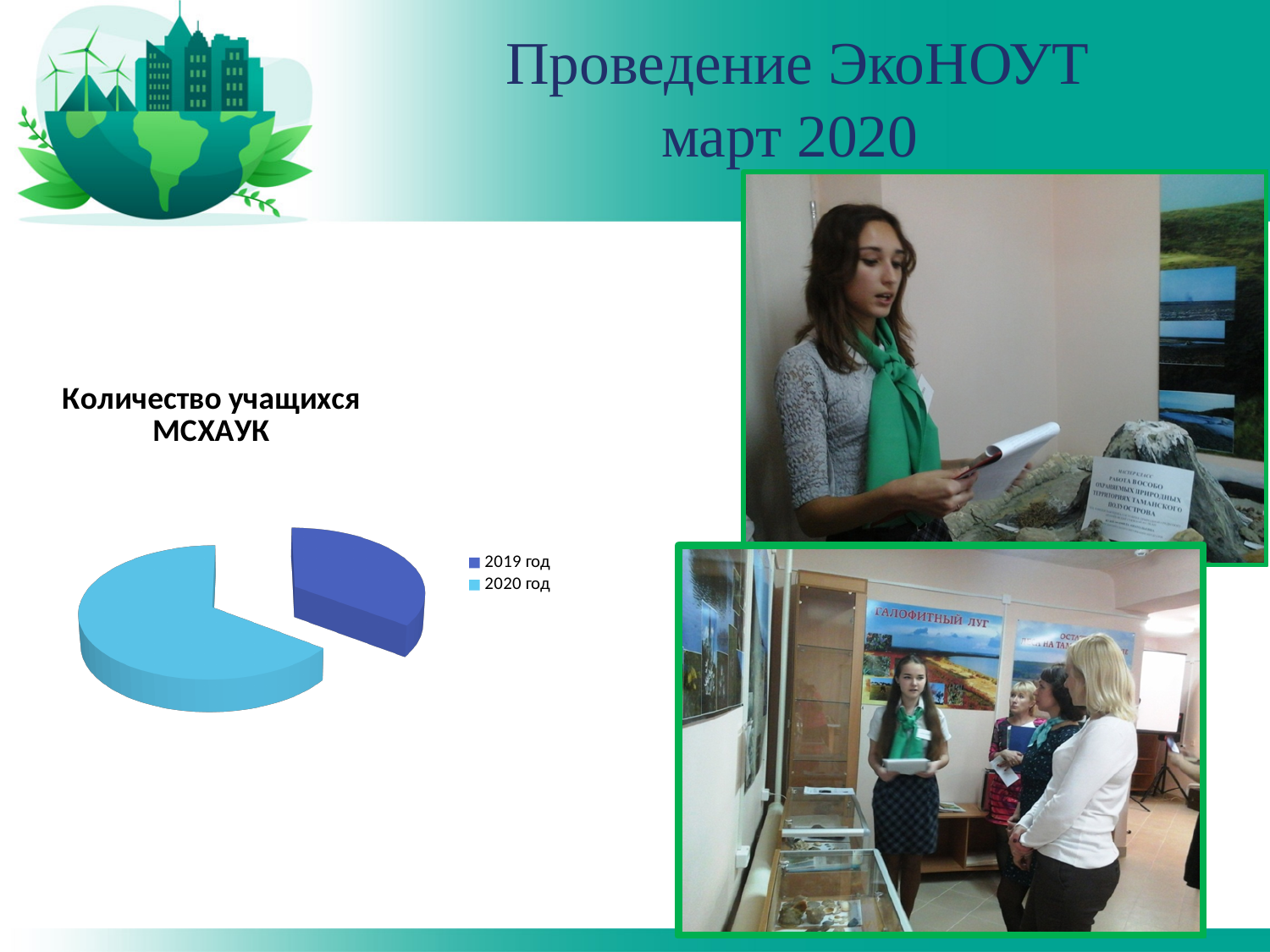
How many slices does the pie chart have? 2 Which slice is larger, 2019 год or 2020 год? 2020 год What kind of chart is shown on the slide? pie chart How many entries does the chart legend list? 2 Which legend entry is shown in light blue? 2020 год Does the slice for 2020 год take up more or less than half of the pie? more Which category has the largest slice of the pie? 2020 год What is the title of the chart? Количество учащихся МСХАУК Which category has the smallest slice of the pie? 2019 год